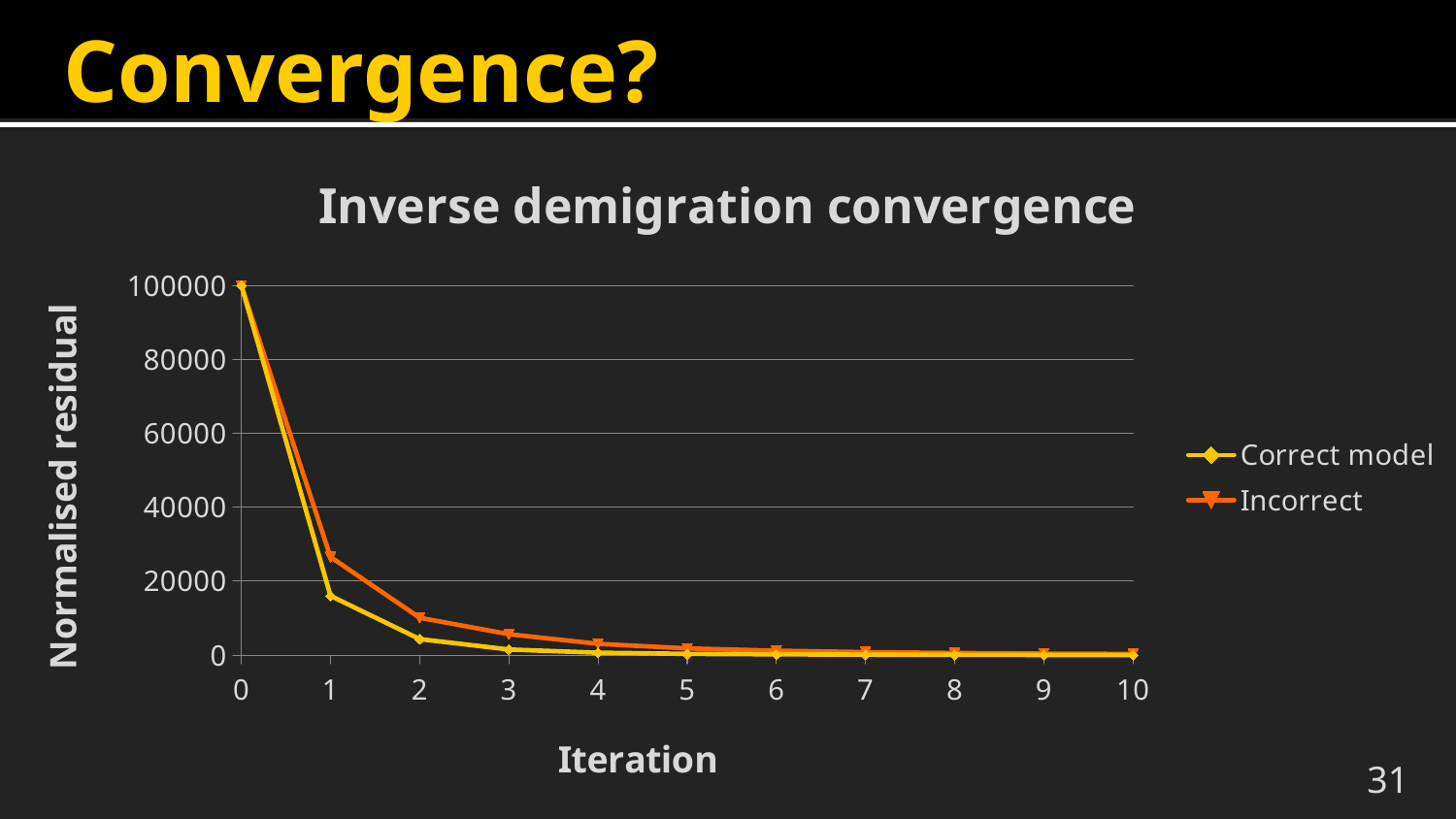
How many iteration points are plotted along the x axis for each series? 11 What is the normalised residual for the Correct model at iteration 0? 100000 At iteration 1, which series has the larger normalised residual, Correct model or Incorrect? Incorrect How many series does the legend list? 2 What is the title of the chart? Inverse demigration convergence Is the normalised residual for the Incorrect series at iteration 2 greater or less than 20000? less What kind of chart is shown on the slide? line chart What is the normalised residual for the Incorrect series at iteration 0? 100000 Is the normalised residual for the Correct model at iteration 1 greater or less than 20000? less What are the names of the two series in the legend? Correct model and Incorrect Do the normalised residual values rise or fall as the iteration increases? fall Is the normalised residual for the Incorrect series at iteration 1 greater or less than 20000? greater